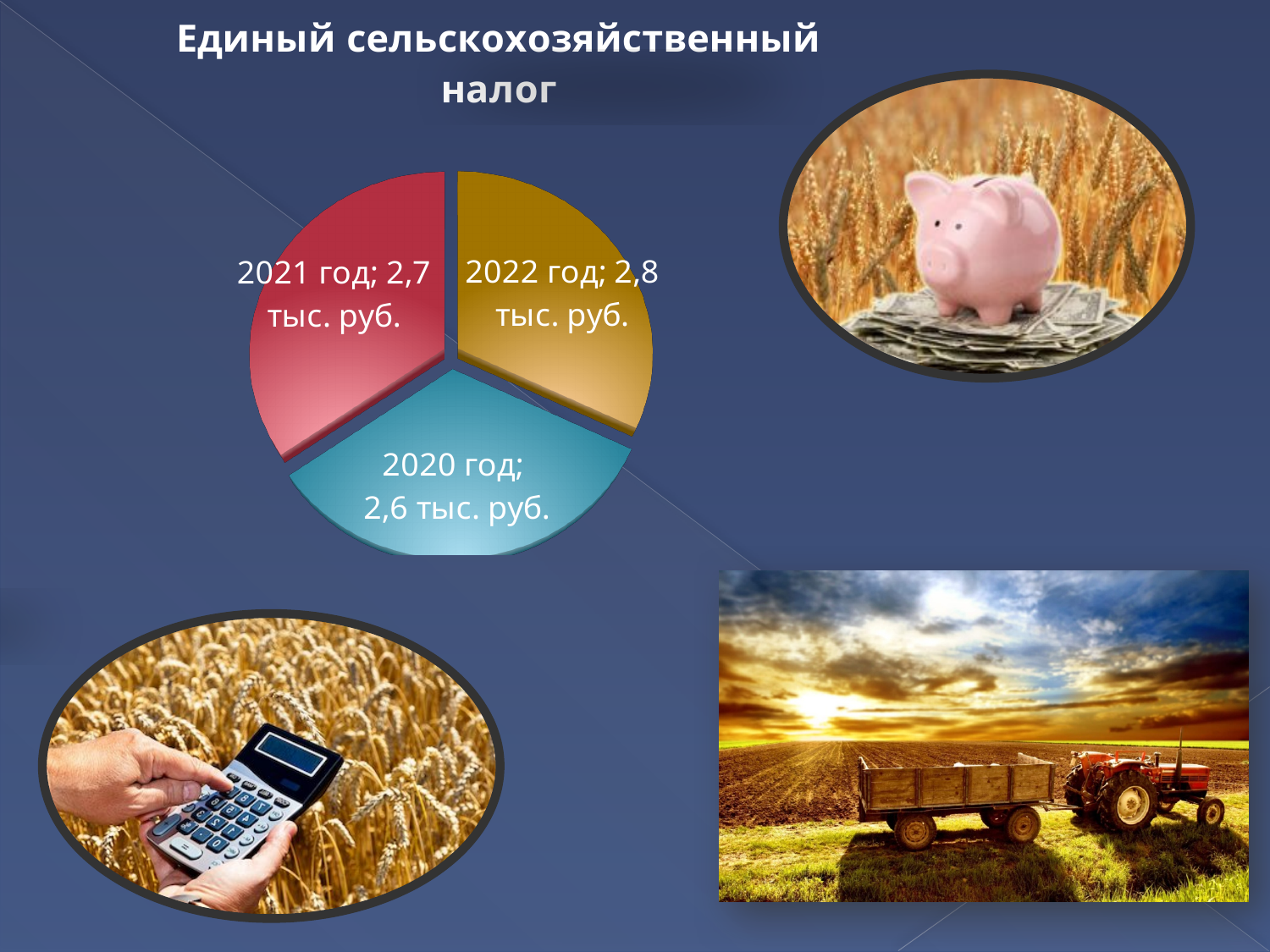
What value is shown for 2020 год in the pie chart? 2,6 тыс. руб. Which year has the largest value in the pie chart? 2022 год What is the difference between the values for 2021 год and 2020 год? 0,1 тыс. руб. What value is shown for 2022 год in the pie chart? 2,8 тыс. руб. How many slices does the pie chart have? 3 Which year has the smallest value in the pie chart? 2020 год What kind of chart is shown on the slide? Pie chart What is the title of the slide containing the pie chart? Единый сельскохозяйственный налог Do the values rise or fall from 2020 год to 2022 год? Rise Which is larger, the value for 2021 год or the value for 2020 год? 2021 год What is the difference between the values for 2022 год and 2020 год? 0,2 тыс. руб. What value is shown for 2021 год in the pie chart? 2,7 тыс. руб.